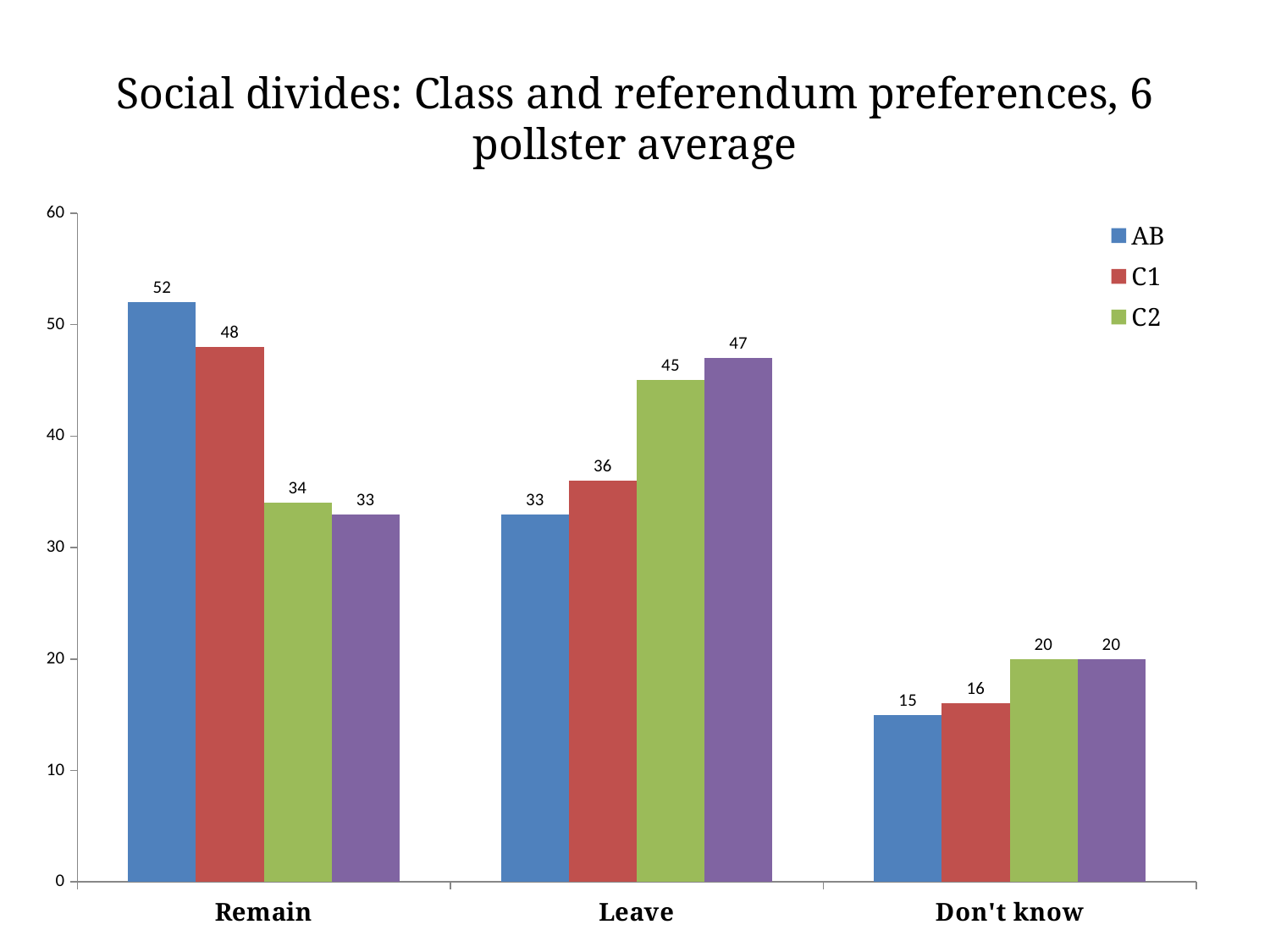
How many categories are shown on the x axis? 3 What kind of chart is shown on the slide? bar chart How many series does the legend list? 3 What is the difference between the AB and C2 values in the Remain category? 18 Is the value for C1 in the Remain category greater or less than 40? greater What is the value for C2 in the Don't know category? 20 Which category has the lowest value for C2? Don't know What is the value for C1 in the Leave category? 36 Which category has the highest value for AB? Remain Which is larger in the Leave category, the value for AB or the value for C2? C2 What is the value for AB in the Don't know category? 15 What is the value for AB in the Remain category? 52